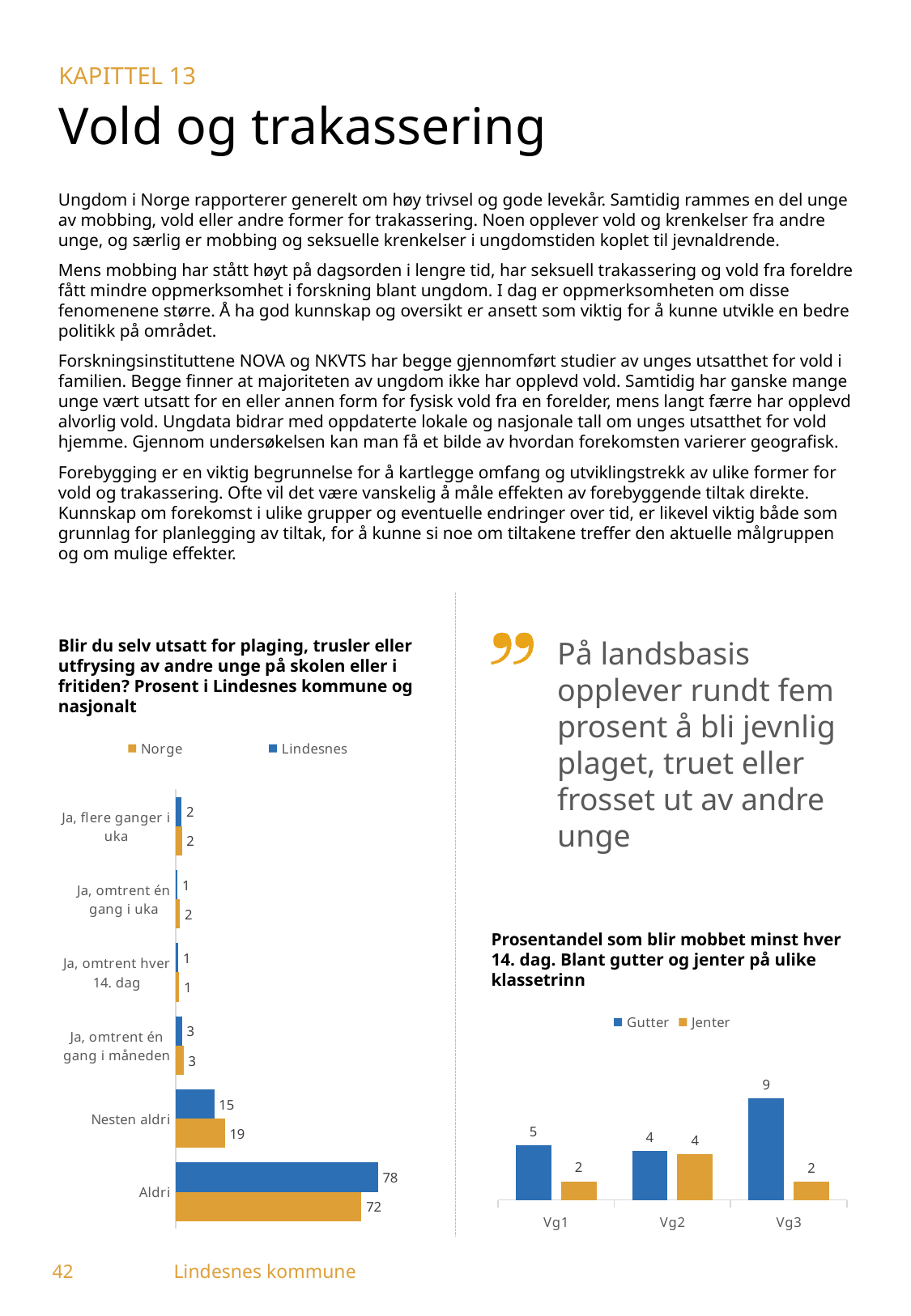
In the chart 'Prosentandel som blir mobbet minst hver 14. dag', which class level has the highest value for Gutter? Vg3 What type of chart is 'Prosentandel som blir mobbet minst hver 14. dag'? Bar chart In the chart 'Blir du selv utsatt for plaging, trusler eller utfrysing av andre unge på skolen eller i fritiden?', which category has the highest value for Lindesnes? Aldri In the chart 'Blir du selv utsatt for plaging, trusler eller utfrysing av andre unge på skolen eller i fritiden?', how many categories are shown? 6 In the chart 'Prosentandel som blir mobbet minst hver 14. dag', what is the value for Gutter at Vg3? 9 In the chart 'Blir du selv utsatt for plaging, trusler eller utfrysing av andre unge på skolen eller i fritiden?', what is the value for Lindesnes in the 'Aldri' category? 78 In the chart 'Blir du selv utsatt for plaging, trusler eller utfrysing av andre unge på skolen eller i fritiden?', how many series does the legend list? 2 In the chart 'Blir du selv utsatt for plaging, trusler eller utfrysing av andre unge på skolen eller i fritiden?', is the value for Norge or Lindesnes larger in the 'Nesten aldri' category? Norge In the chart 'Prosentandel som blir mobbet minst hver 14. dag', what is the difference between Gutter and Jenter at Vg3? 7 In the chart 'Blir du selv utsatt for plaging, trusler eller utfrysing av andre unge på skolen eller i fritiden?', what is the value for Norge in the 'Nesten aldri' category? 19 In the chart 'Blir du selv utsatt for plaging, trusler eller utfrysing av andre unge på skolen eller i fritiden?', what is the difference between the Lindesnes and Norge values for 'Aldri'? 6 In the chart 'Prosentandel som blir mobbet minst hver 14. dag', what is the value for Jenter at Vg2? 4